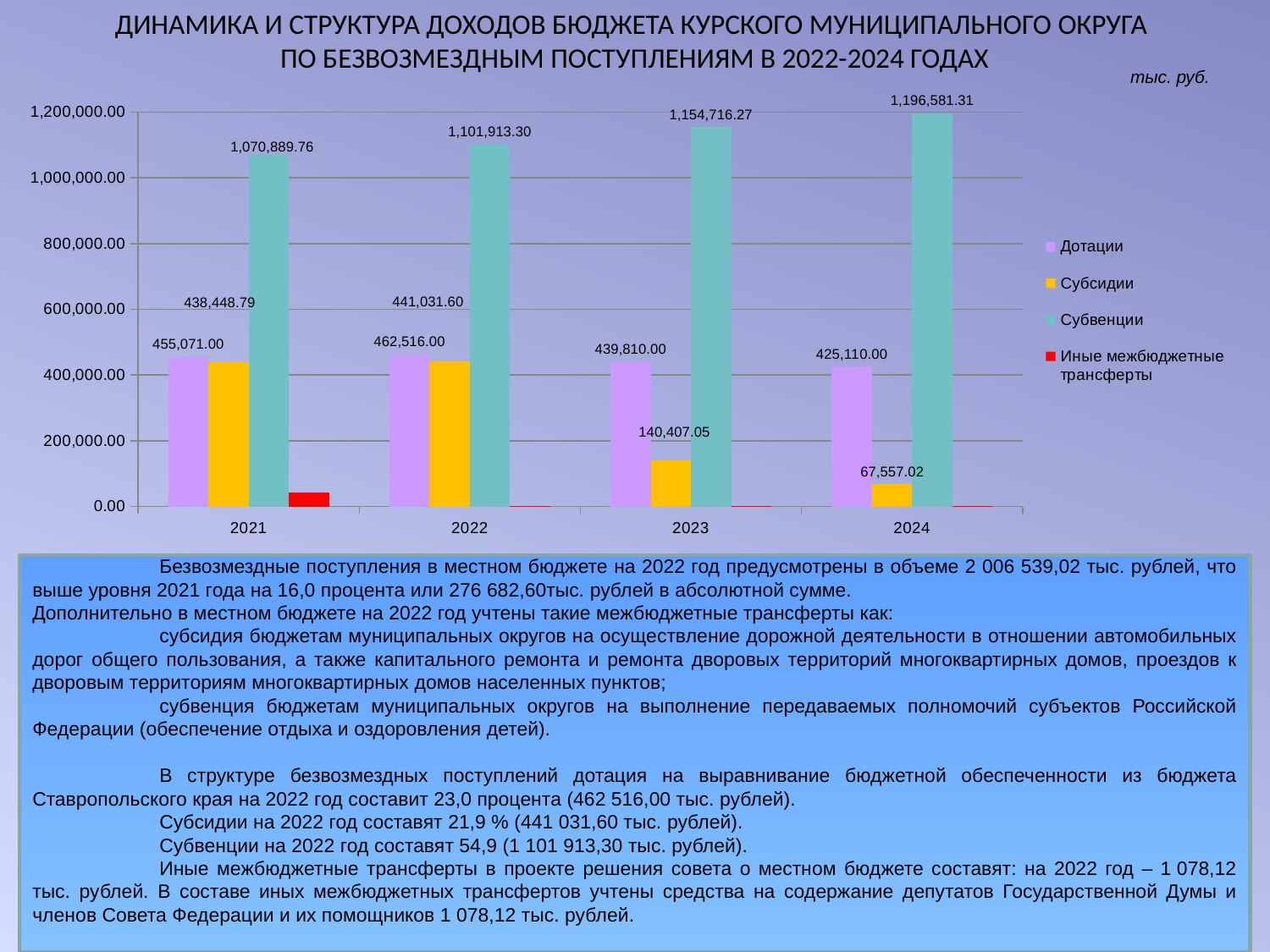
In which year is the value of Субвенции the highest? 2024 What is the difference between the Субсидии values for 2023 and 2024? 72,850.03 What is the difference between the Субвенции values for 2024 and 2021? 125,691.55 How many series does the legend list? 4 Is the value of Иные межбюджетные трансферты for 2021 greater or less than 200,000.00? less What is the value of Субвенции for 2022? 1,101,913.30 In which year is the value of Субсидии the lowest? 2024 How many years are shown on the x axis? 4 Which is larger in 2022: Дотации or Субсидии? Дотации Do the values of Субвенции rise or fall from 2021 to 2024? rise What is the value of Дотации for 2024? 425,110.00 What is the value of Субсидии for 2023? 140,407.05